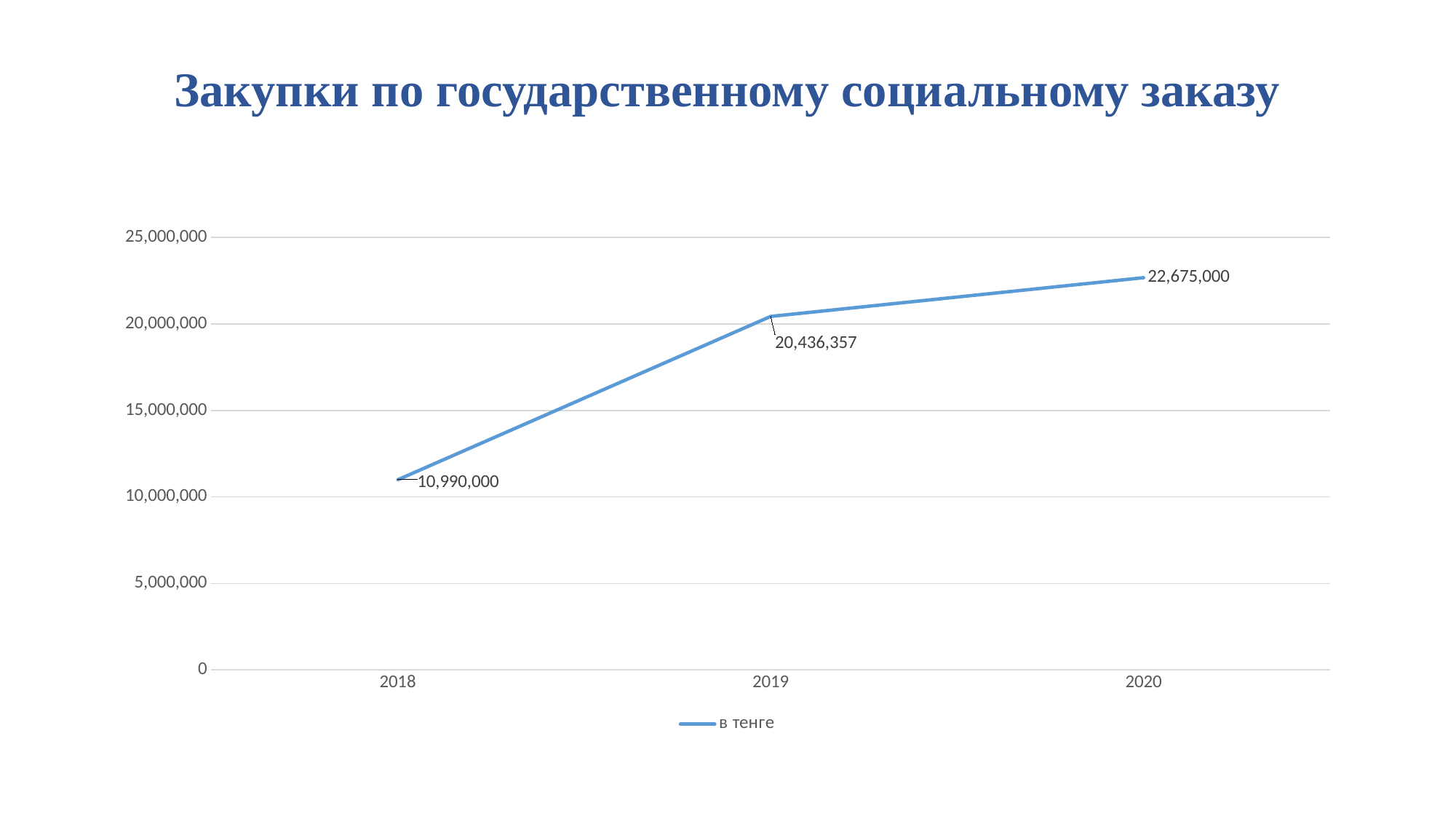
Which year has the lowest value? 2018 What kind of chart is shown on the slide? line chart Which year has the highest value? 2020 Is the value for 2019 greater or less than 20,000,000? greater Do the values rise or fall from 2018 to 2020? rise How many years are plotted on the chart? 3 What is the value for 2019? 20,436,357 What is the difference between the values for 2019 and 2018? 9,446,357 What is the difference between the values for 2020 and 2018? 11,685,000 What is the value for 2018? 10,990,000 What is the value for 2020? 22,675,000 Which is larger, the value for 2019 or the value for 2020? 2020